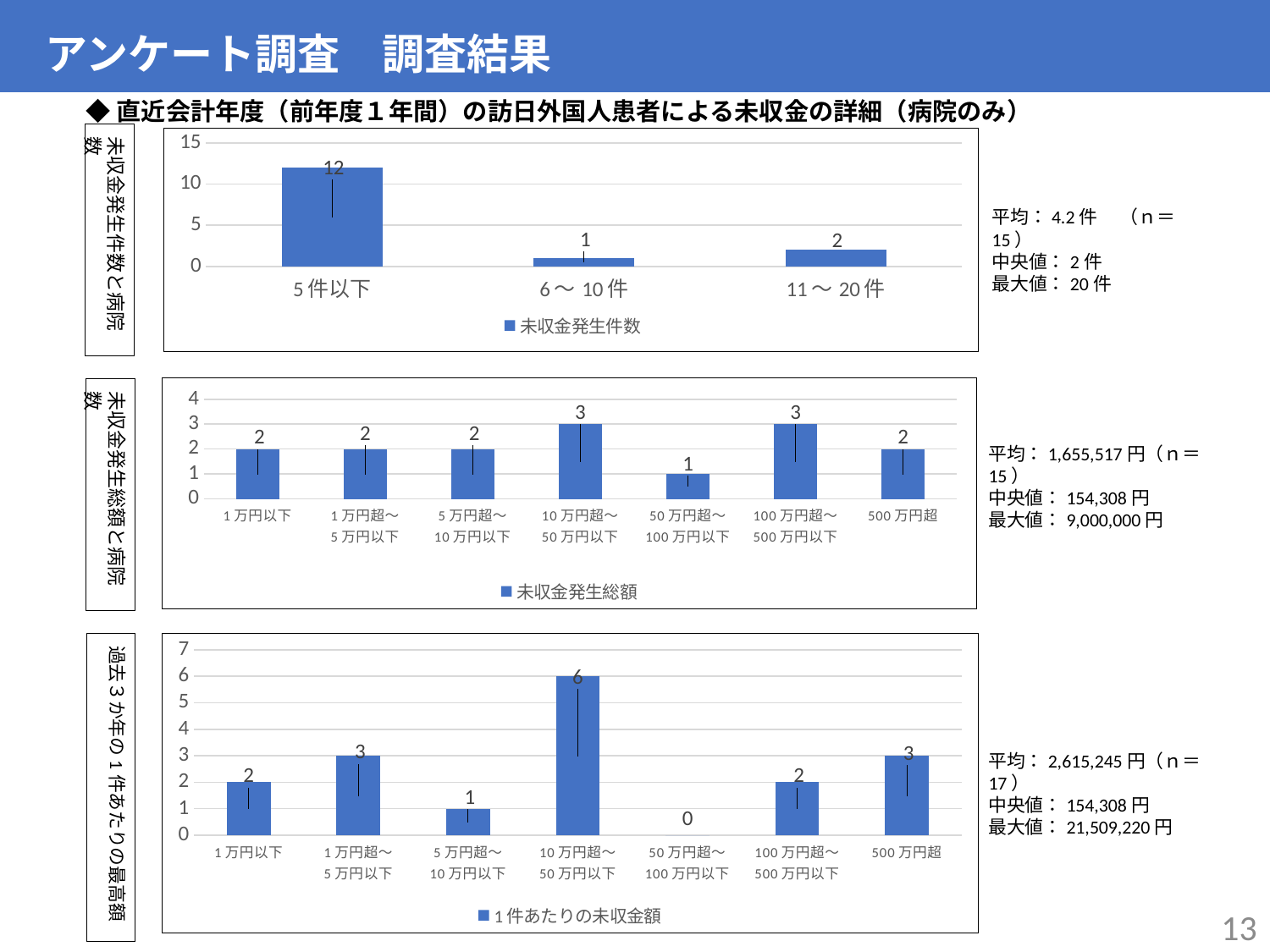
In the top chart, what is the difference between the values for 5件以下 and 11～20件? 10 In the middle chart, what is the value for 50万円超～100万円以下? 1 In the top chart, what is the value for 5件以下? 12 In the bottom chart, which category has the highest value? 10万円超～50万円以下 In the middle chart, which is larger, the value for 10万円超～50万円以下 or the value for 500万円超? 10万円超～50万円以下 What is the legend entry of the bottom chart? 1件あたりの未収金額 In the bottom chart, what is the difference between the values for 10万円超～50万円以下 and 1万円超～5万円以下? 3 In the top chart, which category has the lowest value? 6～10件 What kind of chart is the bottom chart? Bar chart In the bottom chart, what is the value for 50万円超～100万円以下? 0 How many categories are shown in the top chart? 3 How many categories are shown in the middle chart? 7